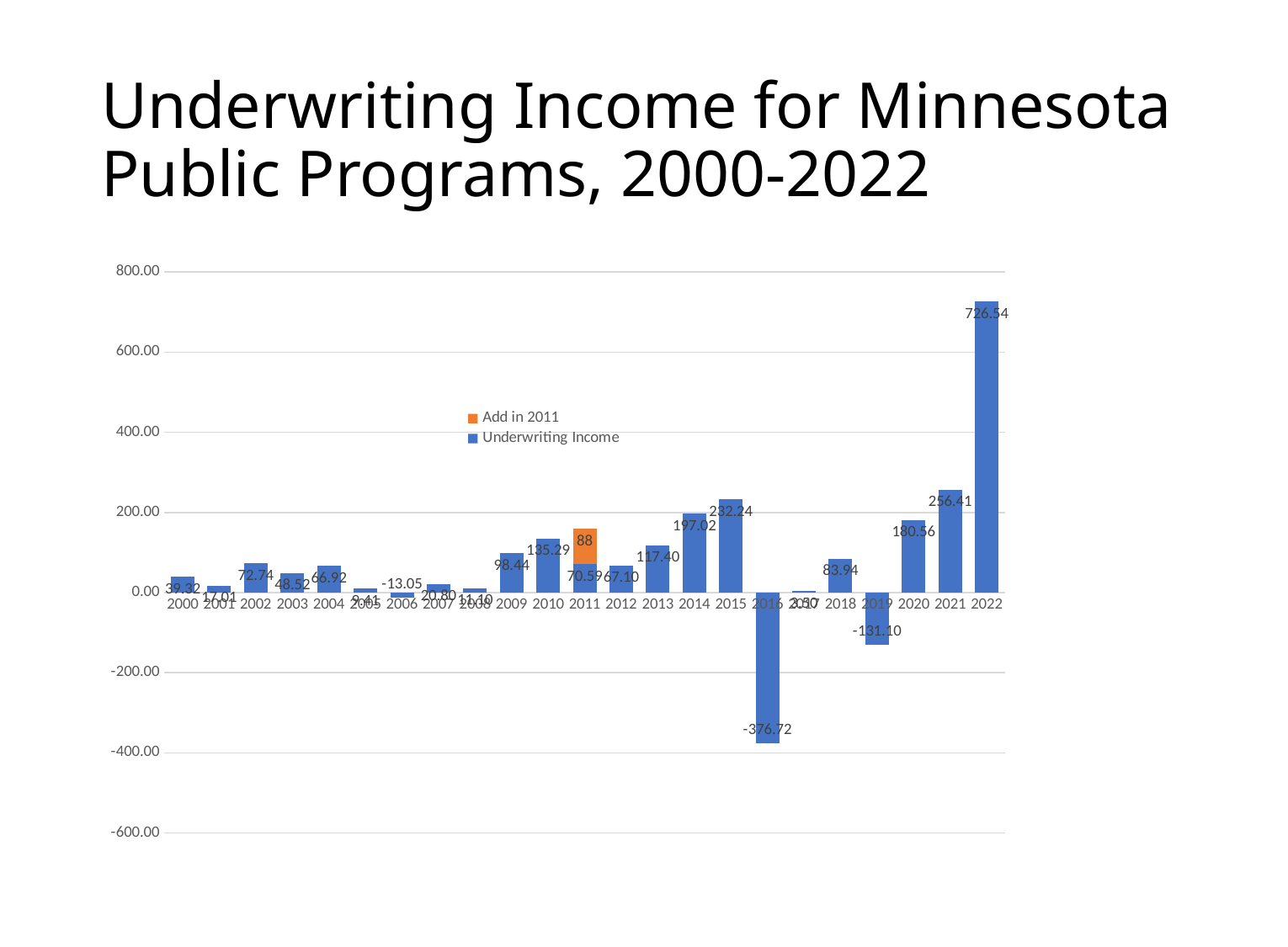
What kind of chart is shown on the slide? Bar chart What is the difference between the Underwriting Income values for 2021 and 2020? 75.85 What is the Underwriting Income value for 2022? 726.54 Which year has the highest Underwriting Income? 2022 What is the total of the stacked bar for 2011 (Underwriting Income plus Add in 2011)? 158.59 Which series is shown in orange in the legend? Add in 2011 How many years are shown on the x axis? 23 How many series does the legend list? 2 What is the Underwriting Income value for 2016? -376.72 Which year has the larger Underwriting Income, 2014 or 2015? 2015 Which year has the lowest Underwriting Income? 2016 What is the Underwriting Income value for 2019? -131.10